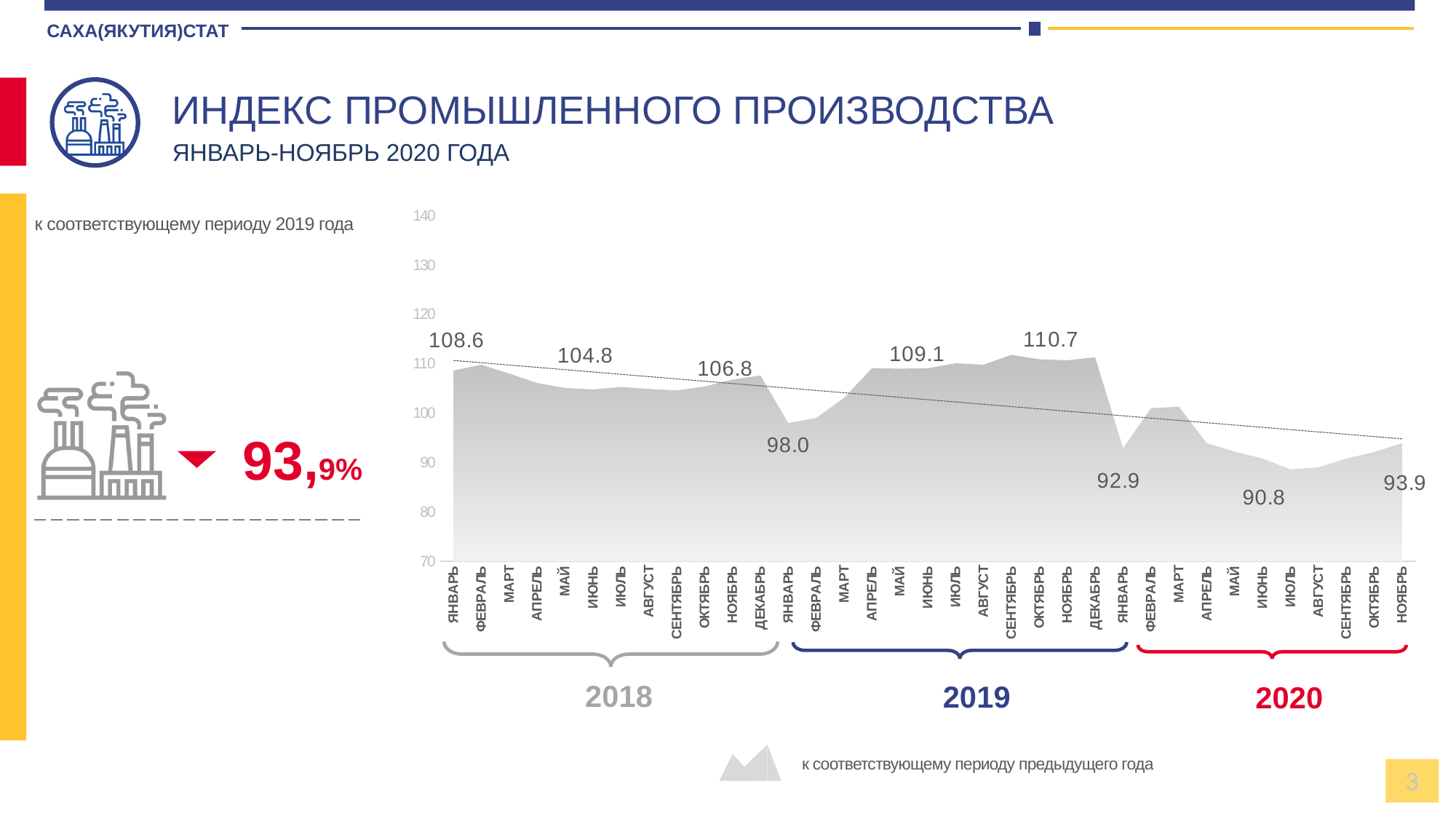
Does the index overall rise or fall from January 2018 to November 2020? fall What is the value of the industrial production index for January 2018 (ЯНВАРЬ 2018)? 108.6 What is the value of the industrial production index for November 2020 (НОЯБРЬ 2020)? 93.9 How many months of 2020 are plotted on the chart? 11 What is the difference between the values for January 2018 and January 2020? 15.7 What is the lowest value labelled on the chart? 90.8 What is the value of the industrial production index for January 2019 (ЯНВАРЬ 2019)? 98.0 Which is larger: the value for January 2019 or the value for November 2020? January 2019 Is the value for July 2020 (ИЮЛЬ 2020) greater or less than 100? less What is the value of the industrial production index for January 2020 (ЯНВАРЬ 2020)? 92.9 What kind of chart is shown on the slide? area chart What is the highest value labelled on the chart? 110.7